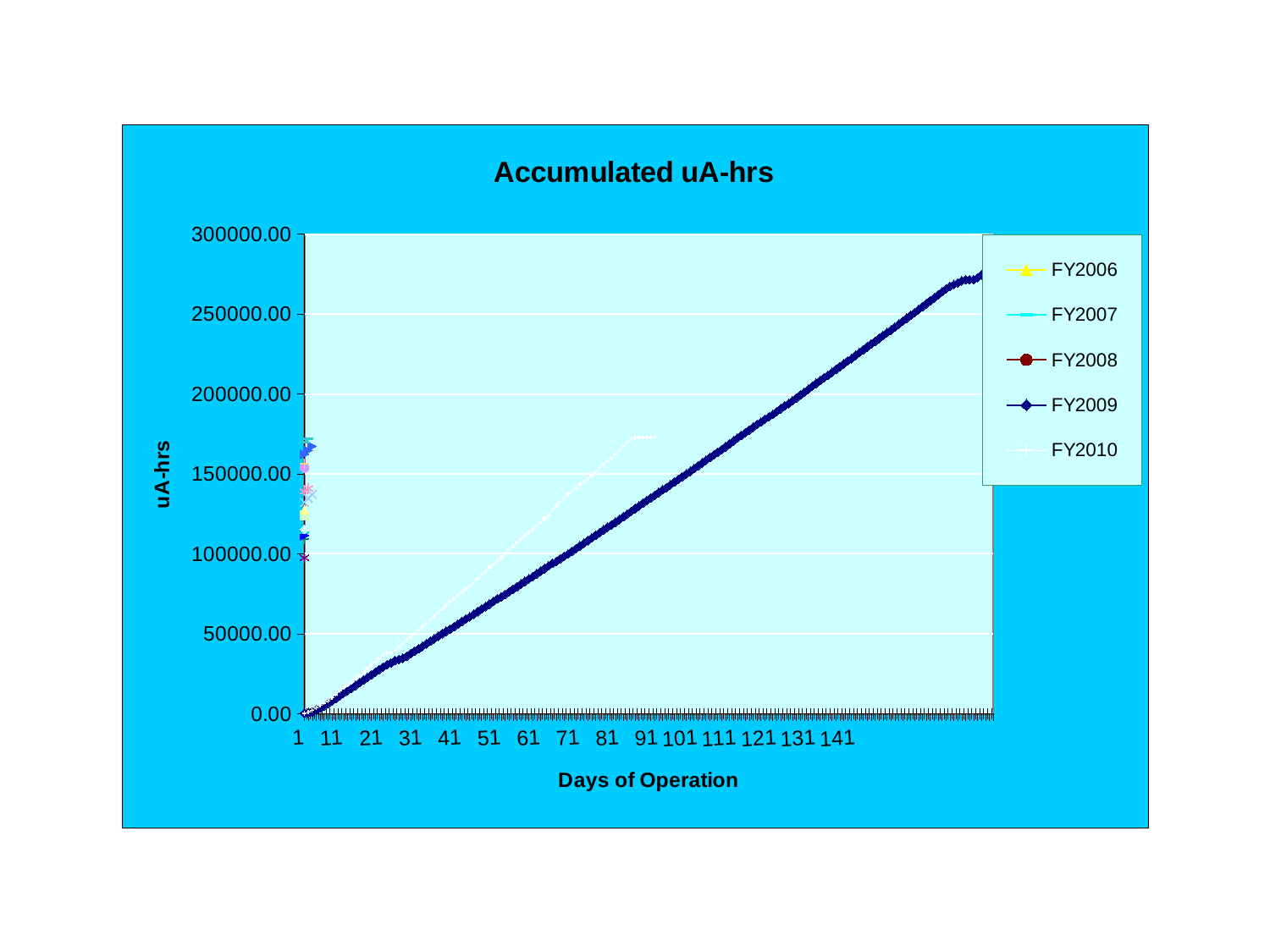
Is the FY2009 value at day 51 greater or less than 100000.00? less Is the highest value reached by the FY2010 line greater or less than 200000.00? less What is the title of the chart? Accumulated uA-hrs Does the FY2010 line rise or fall along the x axis? rise How many series does the legend list? 5 Which series extends to the most days of operation on the chart? FY2009 What kind of chart is shown on the slide? line chart Is the highest value reached by the FY2010 line greater or less than 150000.00? greater What is the label of the x axis? Days of Operation Which series reaches the highest accumulated uA-hrs value on the chart, FY2009 or FY2010? FY2009 Does the FY2009 line rise or fall as the days of operation increase? rise